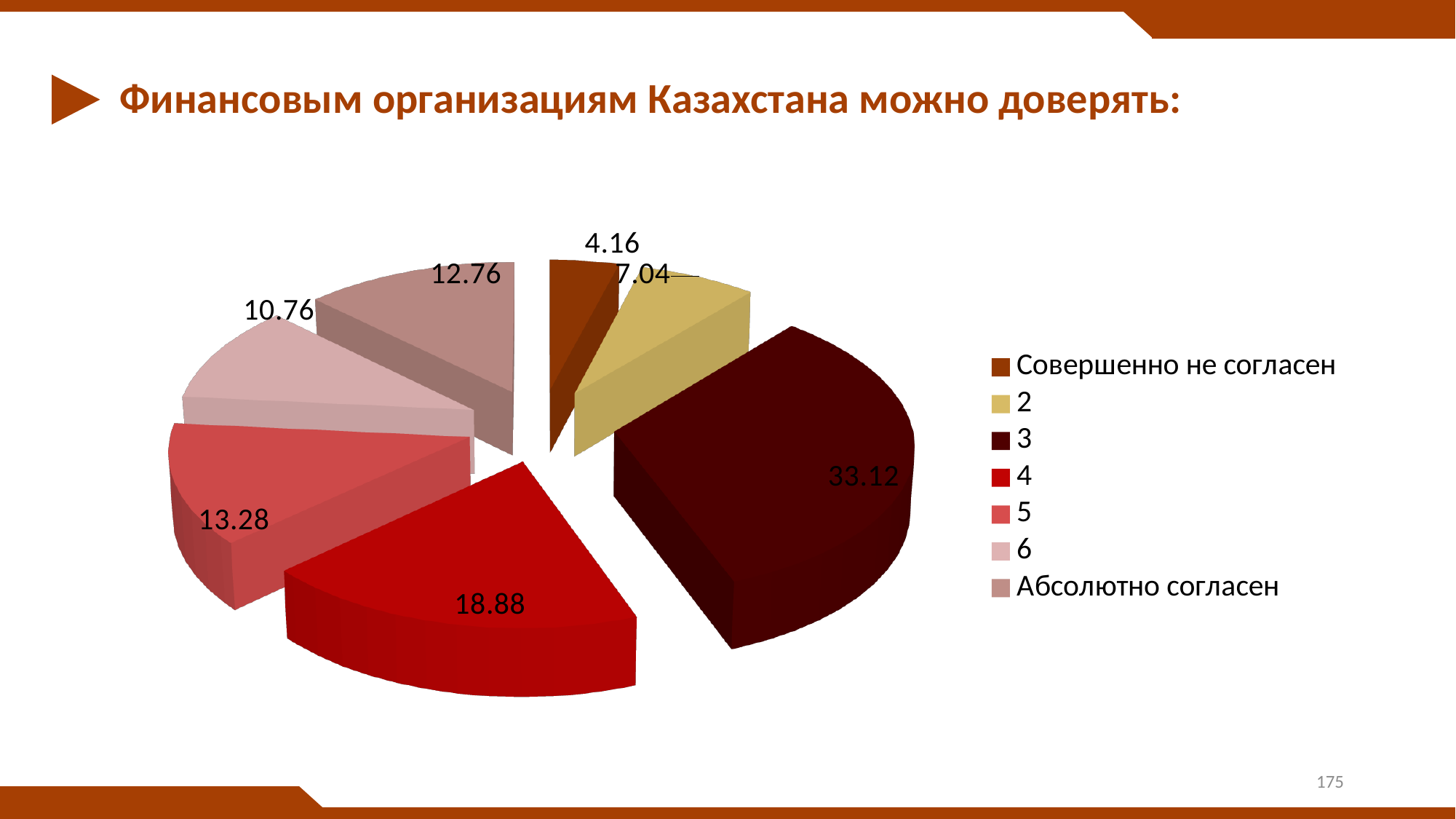
What is the value for "Совершенно не согласен"? 4.16 Which category has the smallest slice? Совершенно не согласен What is the difference between the values for "3" and "4"? 14.24 What is the value for the slice labelled "5"? 13.28 What is the value for the slice labelled "3"? 33.12 How many slices does the pie chart have? 7 What kind of chart is shown on the slide? pie chart What is the difference between the values for "2" and "Совершенно не согласен"? 2.88 What is the title of the slide containing the chart? Финансовым организациям Казахстана можно доверять: Which is larger, the value for "6" or the value for "Абсолютно согласен"? Абсолютно согласен What is the value for "Абсолютно согласен"? 12.76 Which category has the largest slice? 3